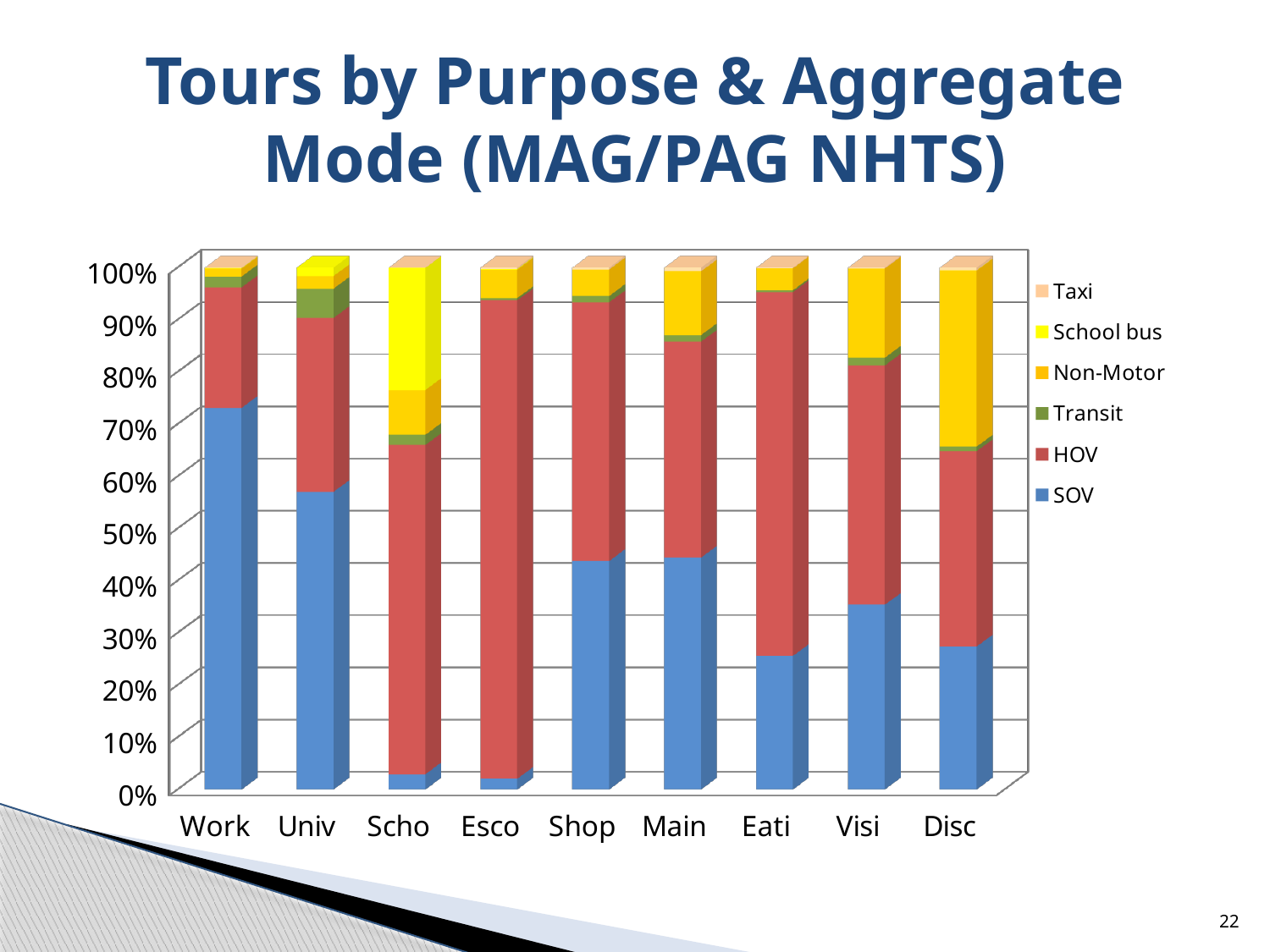
Which category has the largest School bus share? Scho Is the SOV share for Eati greater or less than 40%? less How many tour purpose categories are shown on the x axis? 9 What kind of chart is shown on the slide? stacked bar chart How many series does the legend list? 6 Is the SOV share for Work greater or less than 60%? greater Which category has the largest SOV share? Work Is the SOV share for Esco greater or less than 10%? less Which has the larger SOV share, Work or Univ? Work What is the title of the chart on the slide? Tours by Purpose & Aggregate Mode (MAG/PAG NHTS) Which has the larger Non-Motor share, Disc or Esco? Disc